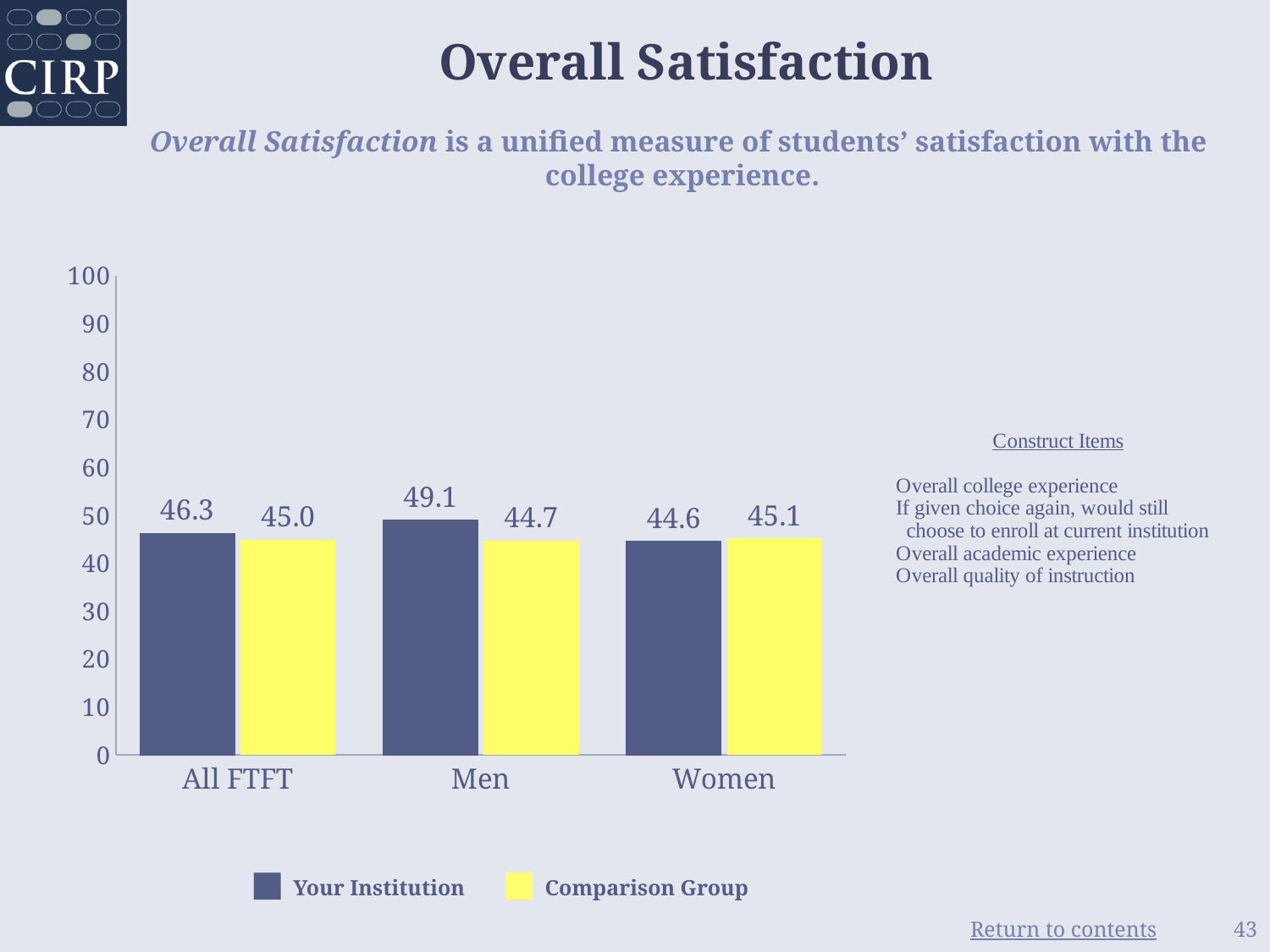
What kind of chart is shown on the slide? bar chart How many series does the legend list? 2 For Women, which is larger: Your Institution or Comparison Group? Comparison Group Is the Your Institution value for Men greater or less than 40? greater How many categories are shown on the x axis? 3 What is the difference between the Your Institution and Comparison Group values for Men? 4.4 What is the Your Institution value for Men? 49.1 What is the Your Institution value for All FTFT? 46.3 What colour represents the Comparison Group series? yellow Which category has the lowest Your Institution value? Women What is the Comparison Group value for Women? 45.1 Which category has the highest Your Institution value? Men